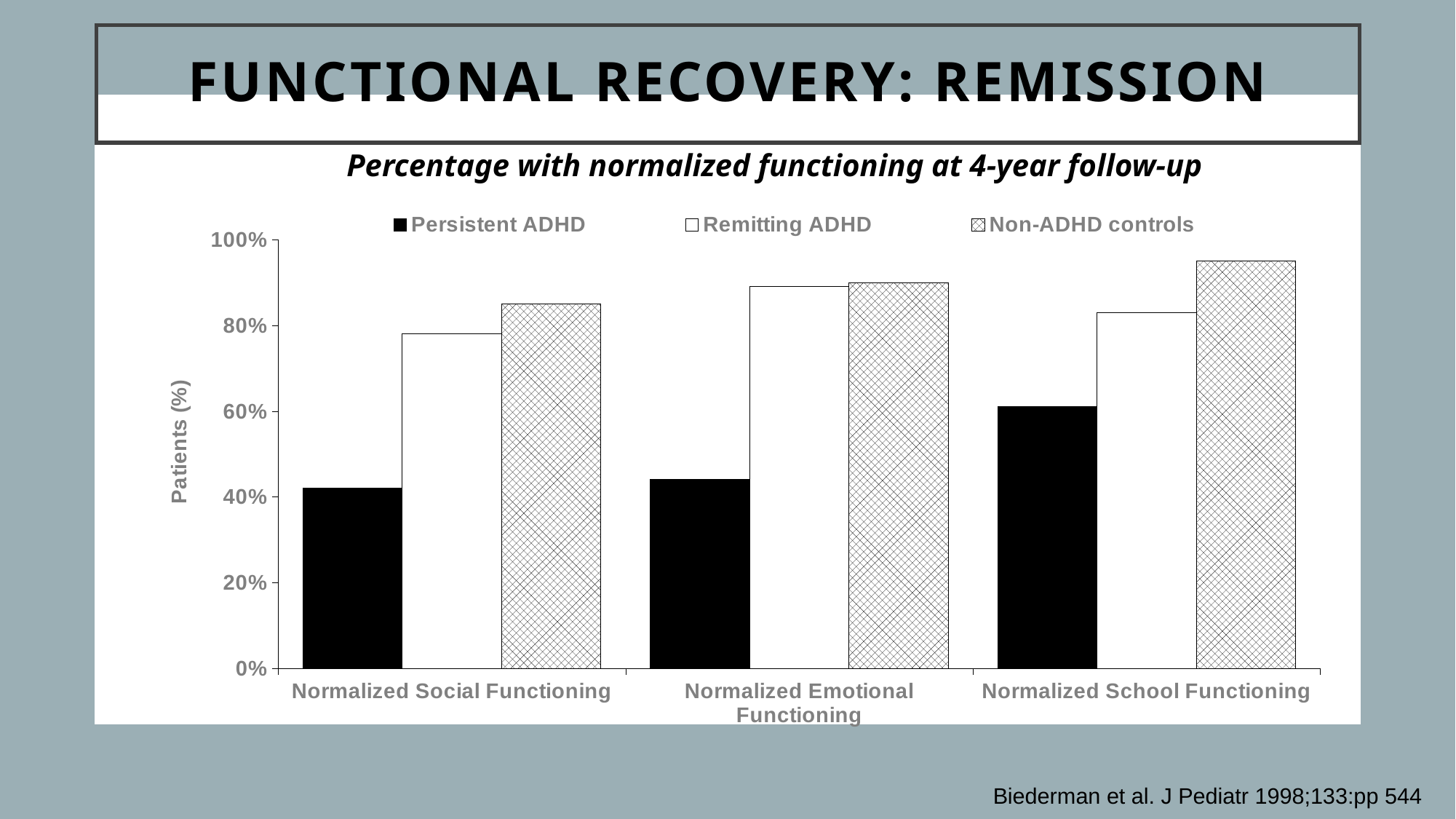
What is the label of the y axis? Patients (%) Is the value for Non-ADHD controls in Normalized School Functioning greater or less than 80%? greater Which series has the highest value for Normalized Social Functioning? Non-ADHD controls Which is larger for Normalized School Functioning: Persistent ADHD or Remitting ADHD? Remitting ADHD How many series does the legend list? 3 For the Remitting ADHD series, which category has the highest value? Normalized Emotional Functioning Which series has the highest value for Normalized School Functioning? Non-ADHD controls Which series has the lowest value for Normalized Social Functioning? Persistent ADHD Is the value for Persistent ADHD in Normalized Social Functioning greater or less than 60%? less How many categories are shown on the x axis? 3 What kind of chart is shown on the slide? bar chart